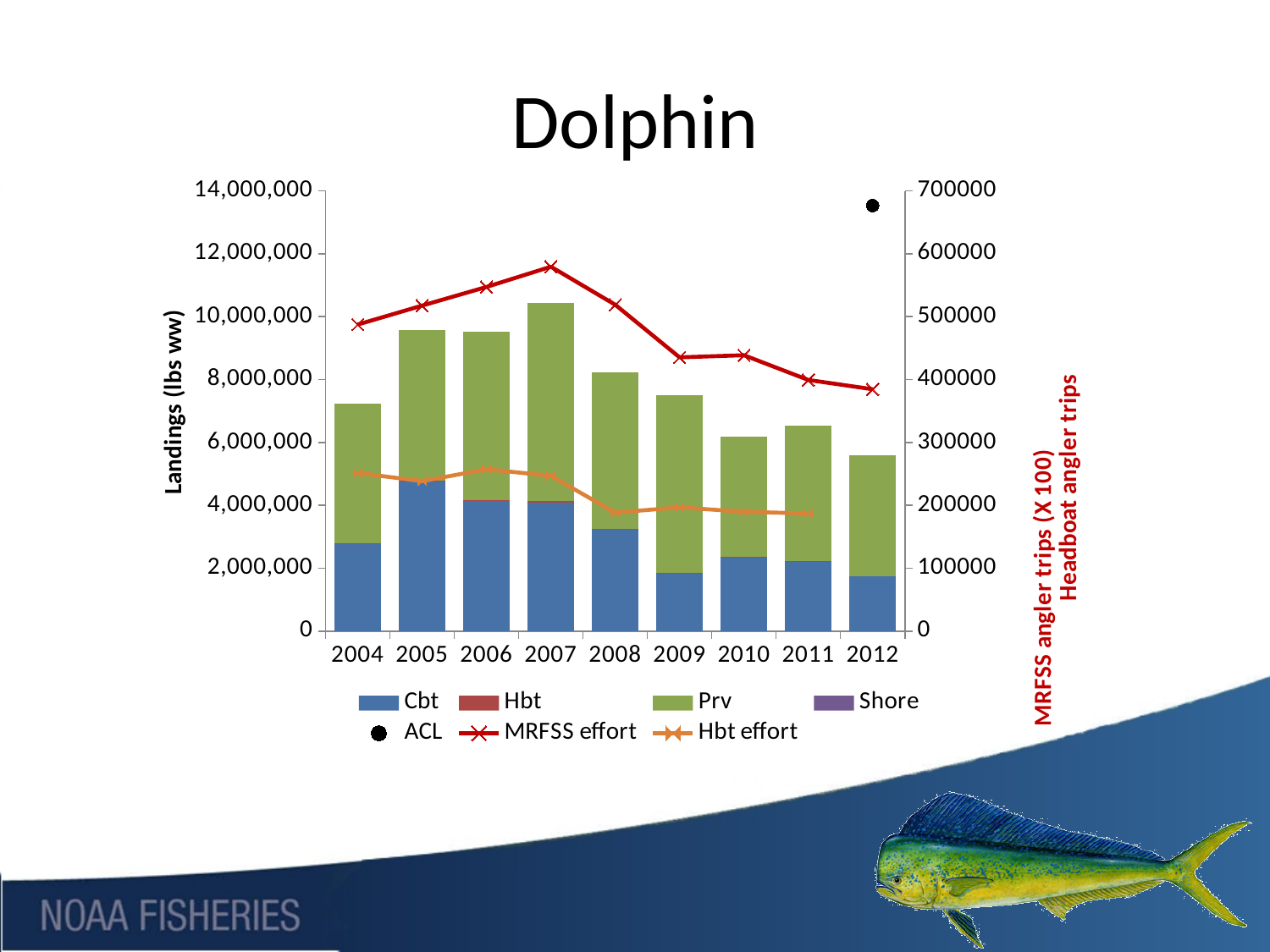
What is the title of the chart? Dolphin Is the total landings bar for 2012 greater or less than 6,000,000? less In which year is the total stacked landings bar the lowest? 2012 How many entries does the chart's legend list? 7 Is the MRFSS effort value for 2007 greater or less than 500000? greater Does the MRFSS effort line rise or fall from 2007 to 2012? fall Which year has the larger total landings bar, 2004 or 2005? 2005 In which year does the MRFSS effort line reach its highest point? 2007 Is the total landings bar for 2007 greater or less than 10,000,000? greater How many years are shown along the x axis of the chart? 9 What kind of chart is shown on the slide? Combination stacked bar and line chart In which year is the total stacked landings bar the highest? 2007